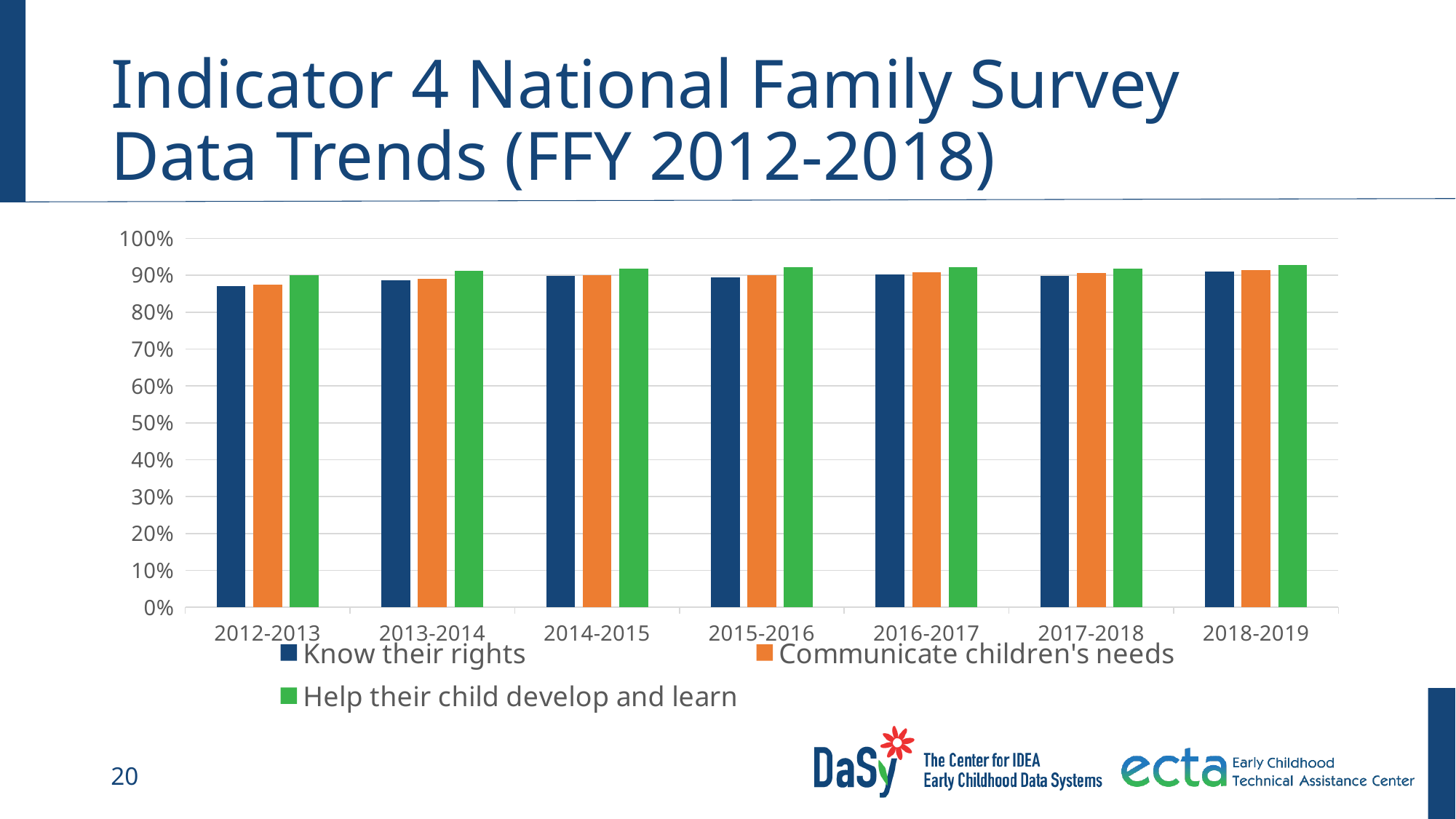
How many year categories are shown on the x axis? 7 In which year is the value for Know their rights lowest? 2012-2013 What kind of chart is shown on the slide? bar chart Is the value for Know their rights in 2012-2013 greater or less than 90%? less Does the value for Know their rights generally rise or fall from 2012-2013 to 2018-2019? rise How many series does the legend list? 3 Is the value for Help their child develop and learn in 2018-2019 greater or less than 90%? greater In 2012-2013, which is larger: Know their rights or Help their child develop and learn? Help their child develop and learn Is the value for Know their rights in 2012-2013 greater or less than 80%? greater Within each year, which series has the highest bar? Help their child develop and learn Which series is shown in orange? Communicate children's needs